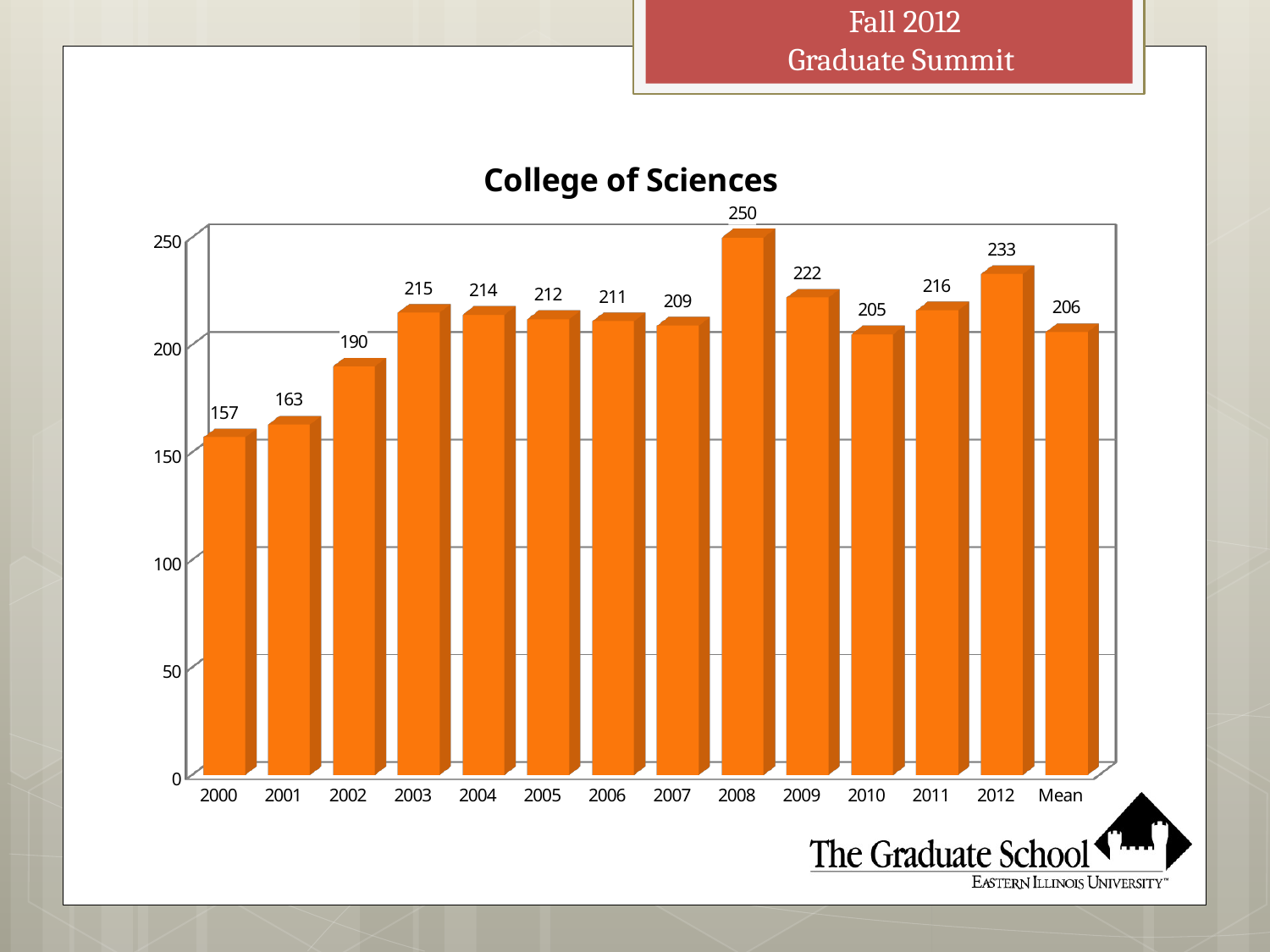
Do the values rise or fall from 2000 to 2003? rise Which is larger, the value for 2009 or the value for 2011? 2009 What is the value for 2000? 157 What is the title of the chart? College of Sciences What is the difference between the values for 2012 and 2010? 28 What kind of chart is shown? bar chart What is the value shown for Mean? 206 How many bars are shown in the chart? 14 Is the value for 2002 greater or less than 200? less What is the value for 2008? 250 Which year has the lowest value? 2000 Which year has the highest value? 2008